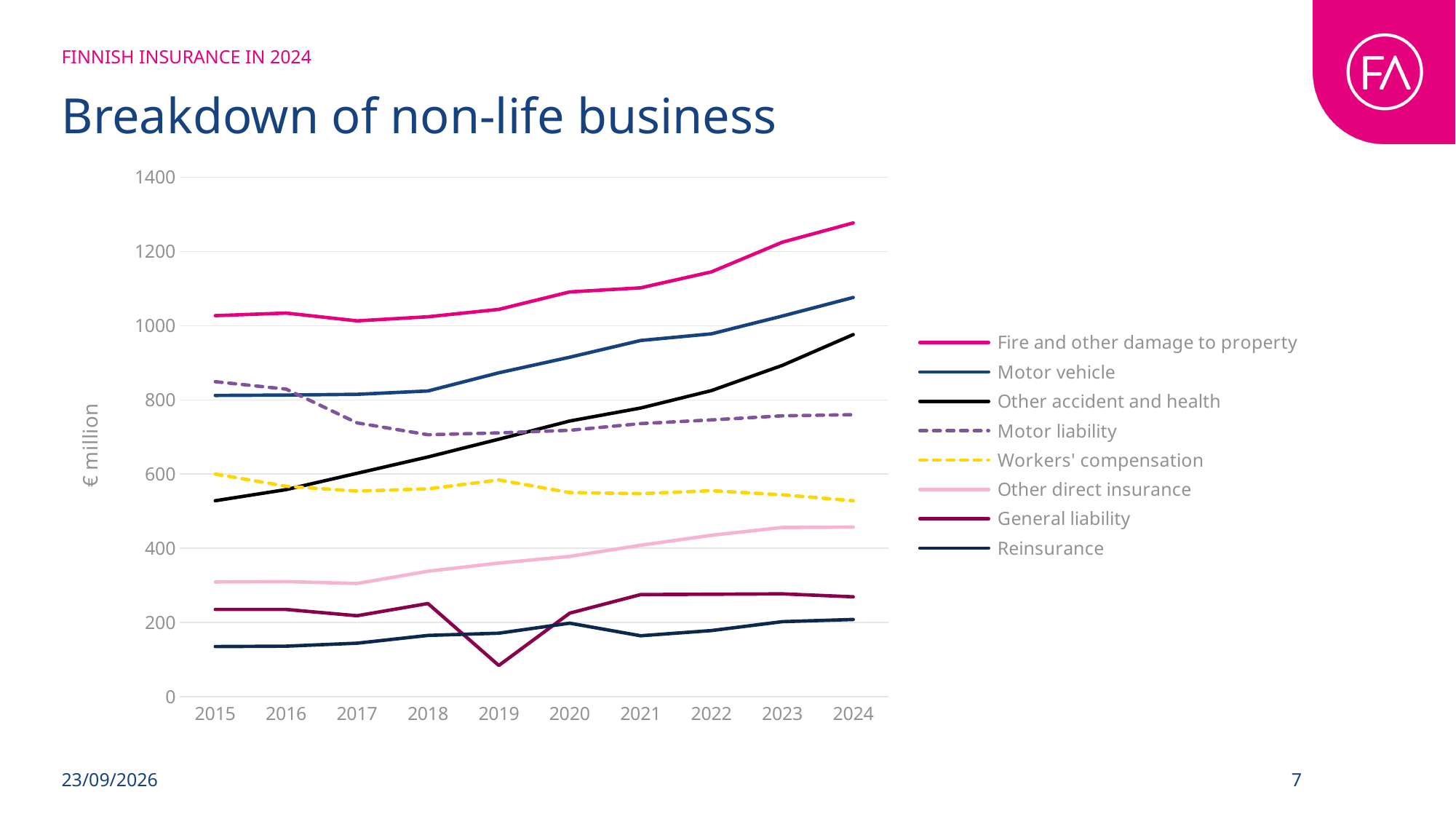
What is the label on the y axis? € million Which series has the lowest value in 2024? Reinsurance How many series does the legend list? 8 What kind of chart is shown on the slide? Line chart Which series has the lowest value in 2019? General liability Which series has the highest value in 2024? Fire and other damage to property How many years are shown on the x axis? 10 Does the Other accident and health series rise or fall from 2015 to 2024? Rise Is the value for Other accident and health in 2015 greater or less than 600? less Is the value for Fire and other damage to property in 2024 greater or less than 1200? greater Is the value for Motor vehicle in 2024 greater or less than 1000? greater Which is larger in 2024, Motor vehicle or Motor liability? Motor vehicle